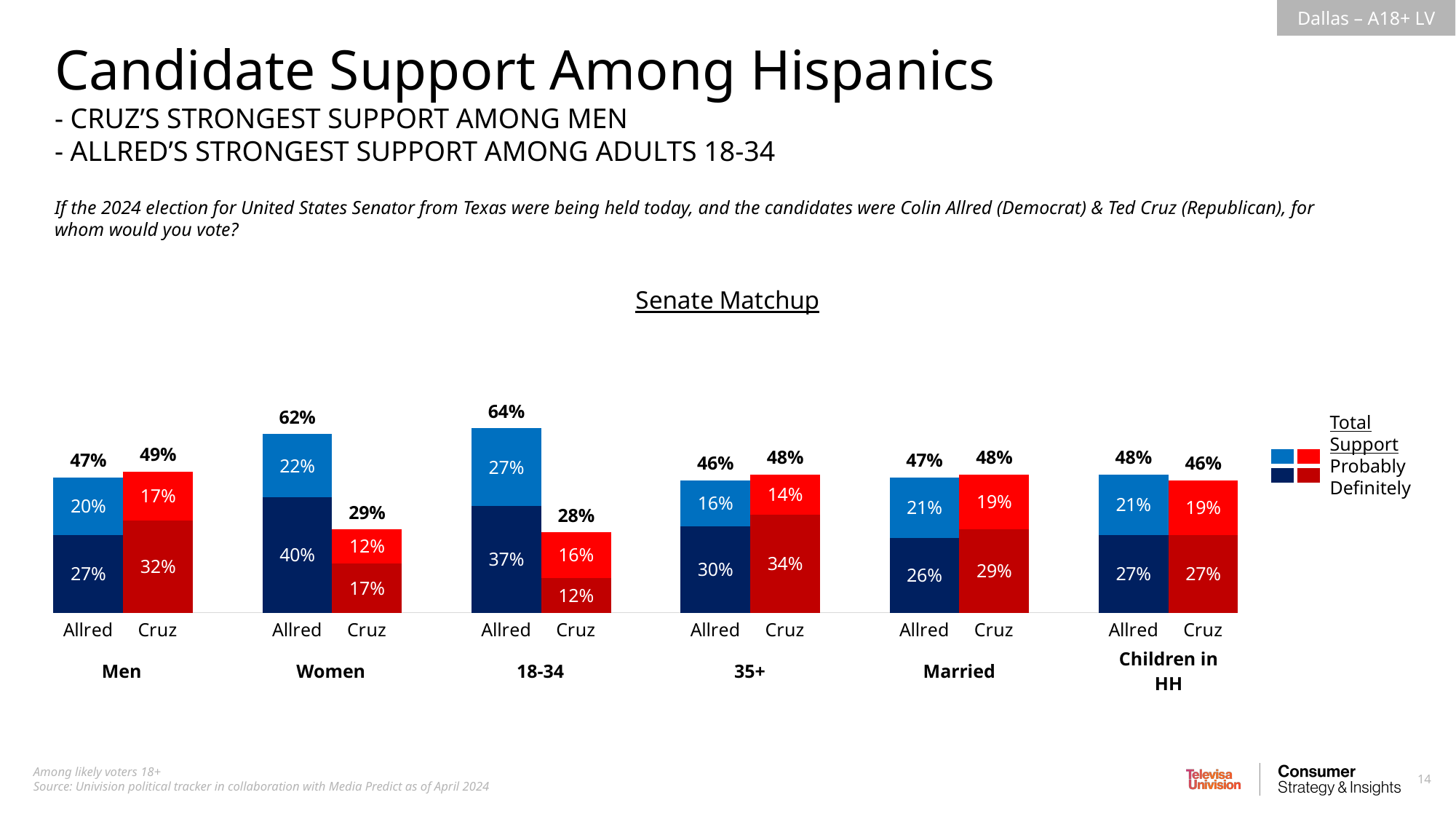
Which demographic group shows the highest total support for Allred? 18-34 Among Men, who has the higher total support, Allred or Cruz? Cruz What is the total of the stacked bar for Allred among adults 18-34? 64% Which demographic group shows the lowest total support for Cruz? 18-34 What is the total support for Allred among Men? 47% What is the 'Probably' support for Allred among Married respondents? 21% Among Women, what is the difference between Allred's total support and Cruz's total support? 33 percentage points How many series (stack segments) does the legend list? 2 What share of Hispanic adults 35+ say they would definitely vote for Cruz? 34% Among Men, what is the difference between Cruz's 'Definitely' support and Allred's 'Definitely' support? 5 percentage points How many demographic groups are shown in the Senate Matchup chart? 6 What type of chart is used for the Senate Matchup? Stacked bar chart